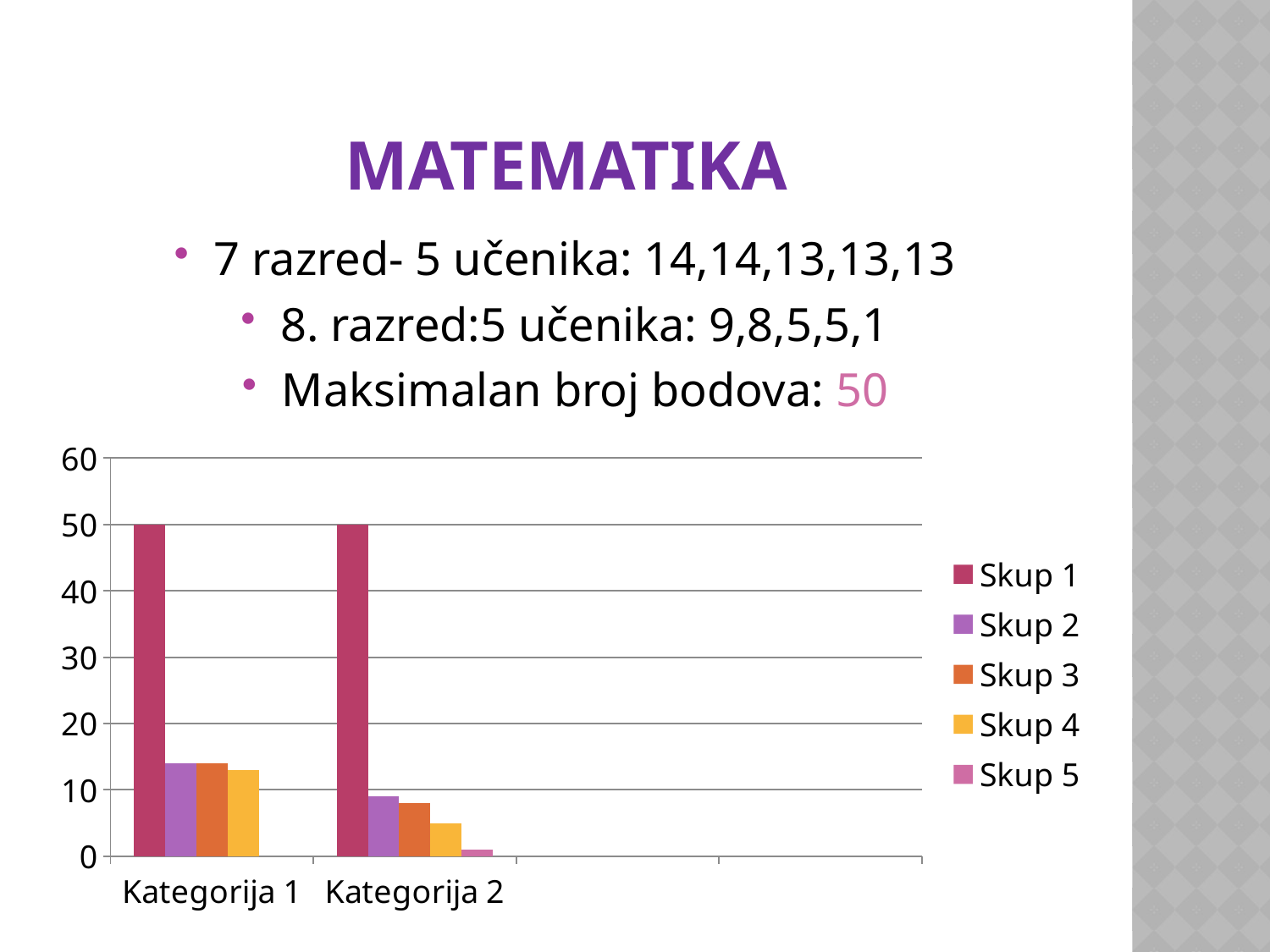
What kind of chart is shown on the slide? Bar chart Is the value for Skup 4 in Kategorija 2 greater or less than 10? less For Skup 4, which category has the larger value, Kategorija 1 or Kategorija 2? Kategorija 1 Is the value for Skup 2 in Kategorija 1 greater or less than 10? greater Which series has the lowest value in Kategorija 2? Skup 5 What is the value of Skup 1 for Kategorija 1? 50 How many series does the chart's legend list? 5 Is the value for Skup 5 in Kategorija 2 greater or less than 10? less What is the value of Skup 1 for Kategorija 2? 50 How many categories are shown on the x axis of the chart? 2 What is the name of the first series listed in the chart's legend? Skup 1 Which series has the highest value in Kategorija 2? Skup 1